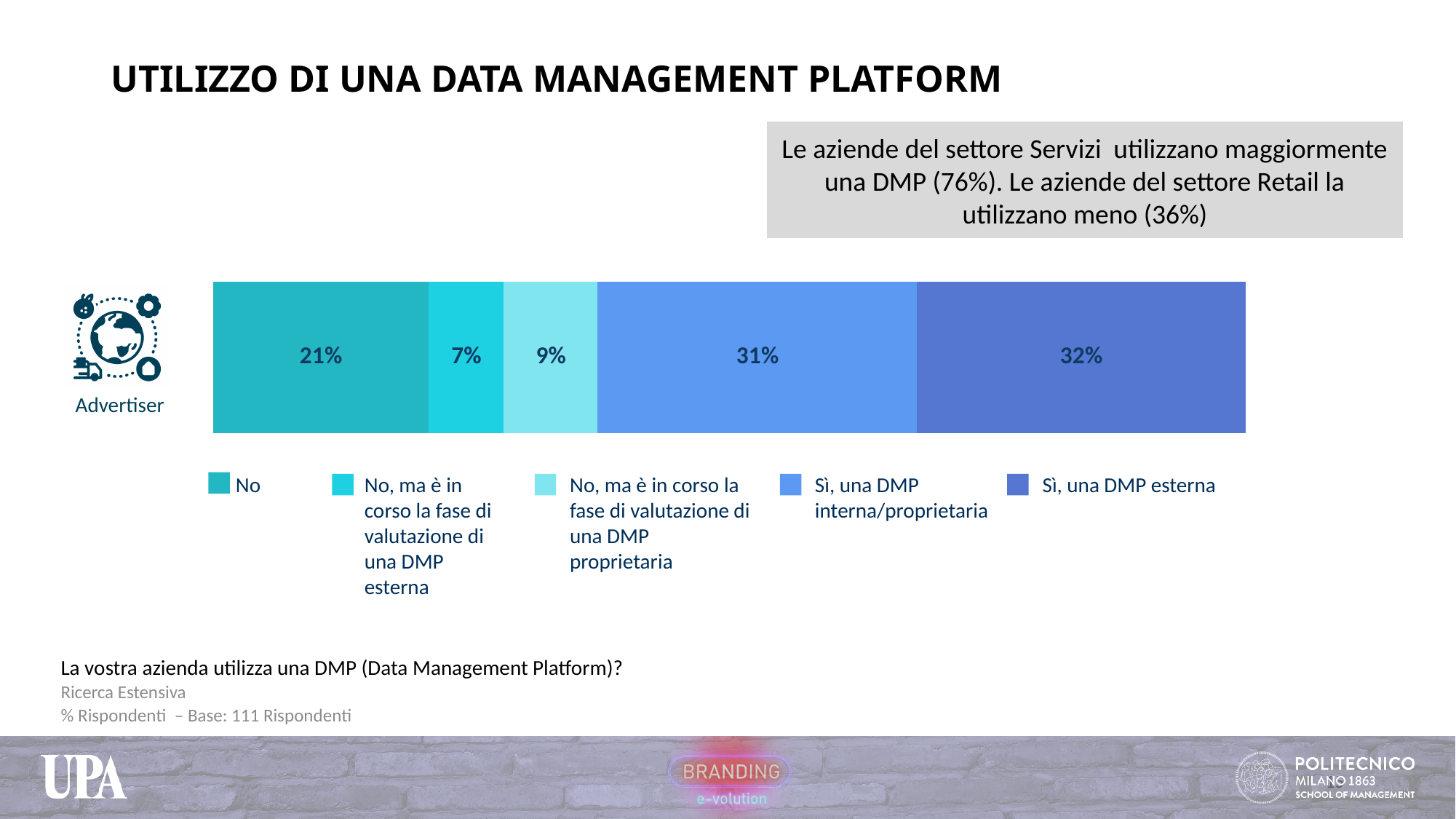
What is the difference between the "No" share and the "No, ma è in corso la fase di valutazione di una DMP proprietaria" share? 12% What is the combined share of the two "Sì" responses? 63% Which response has the smallest share of the bar? No, ma è in corso la fase di valutazione di una DMP esterna Which response has the largest share of the bar? Sì, una DMP esterna What percentage of advertisers answered "Sì, una DMP esterna"? 32% What is the label of the category shown next to the bar? Advertiser What percentage of advertisers answered "Sì, una DMP interna/proprietaria"? 31% What percentage of advertisers answered "No"? 21% How many series does the legend list? 5 What kind of chart is shown on the slide? Stacked bar chart Which is larger: the share for "Sì, una DMP interna/proprietaria" or the share for "No"? Sì, una DMP interna/proprietaria What percentage of advertisers answered "No, ma è in corso la fase di valutazione di una DMP esterna"? 7%